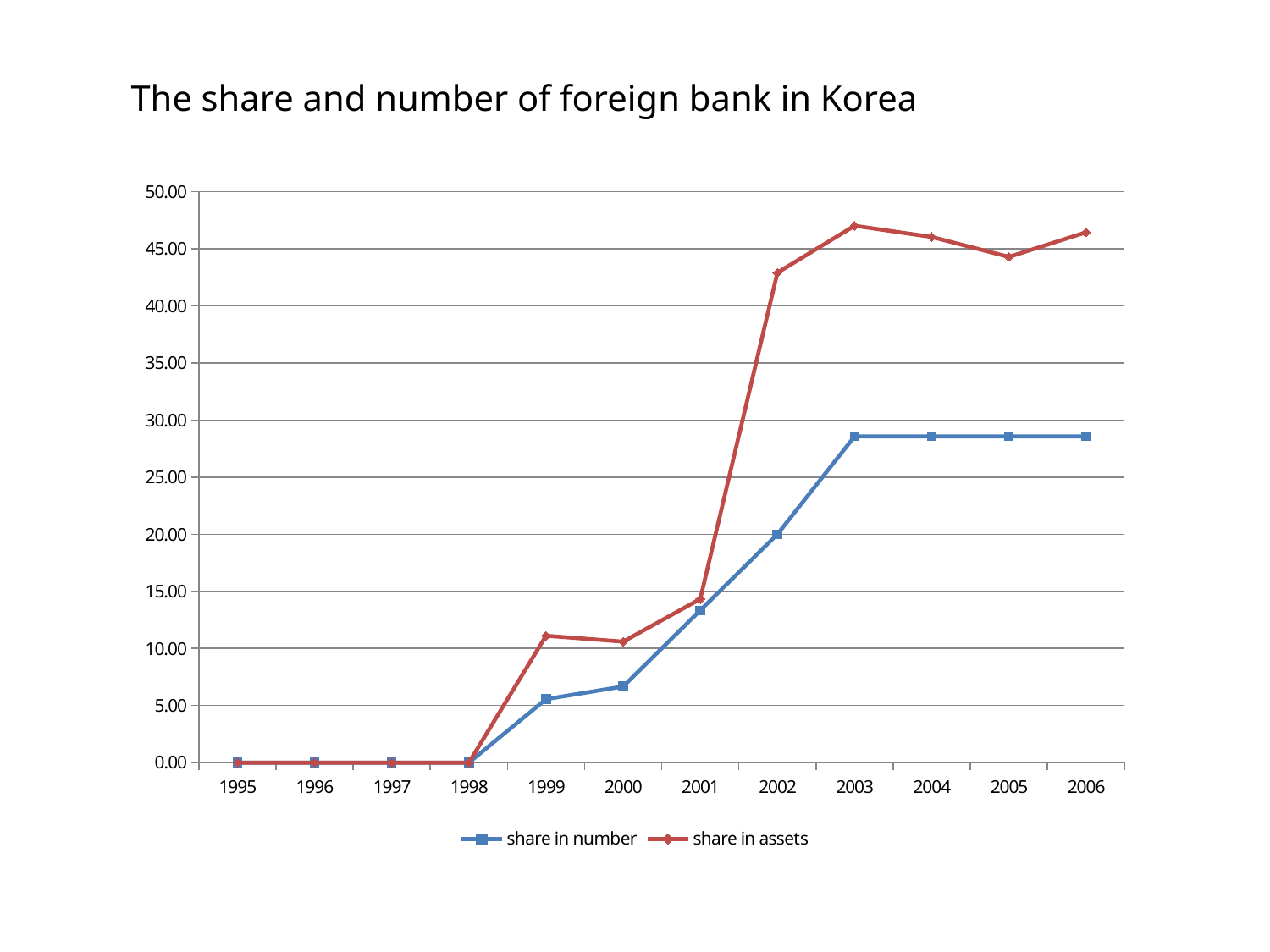
How many years are shown on the x axis? 12 Which year has the highest value for share in assets? 2003 What is the value of share in assets in 1995? 0.00 Is the value of share in assets in 2003 greater or less than 45.00? greater Does share in number rise or fall from 1998 to 2003? rise Is the value of share in assets in 2002 greater or less than 40.00? greater What is the value of share in number in 1998? 0.00 What is the title of the chart? The share and number of foreign bank in Korea Which series is higher in 2004, share in number or share in assets? share in assets What kind of chart is shown on the slide? line chart How many series does the legend list? 2 Is the value of share in number in 2006 greater or less than 30.00? less